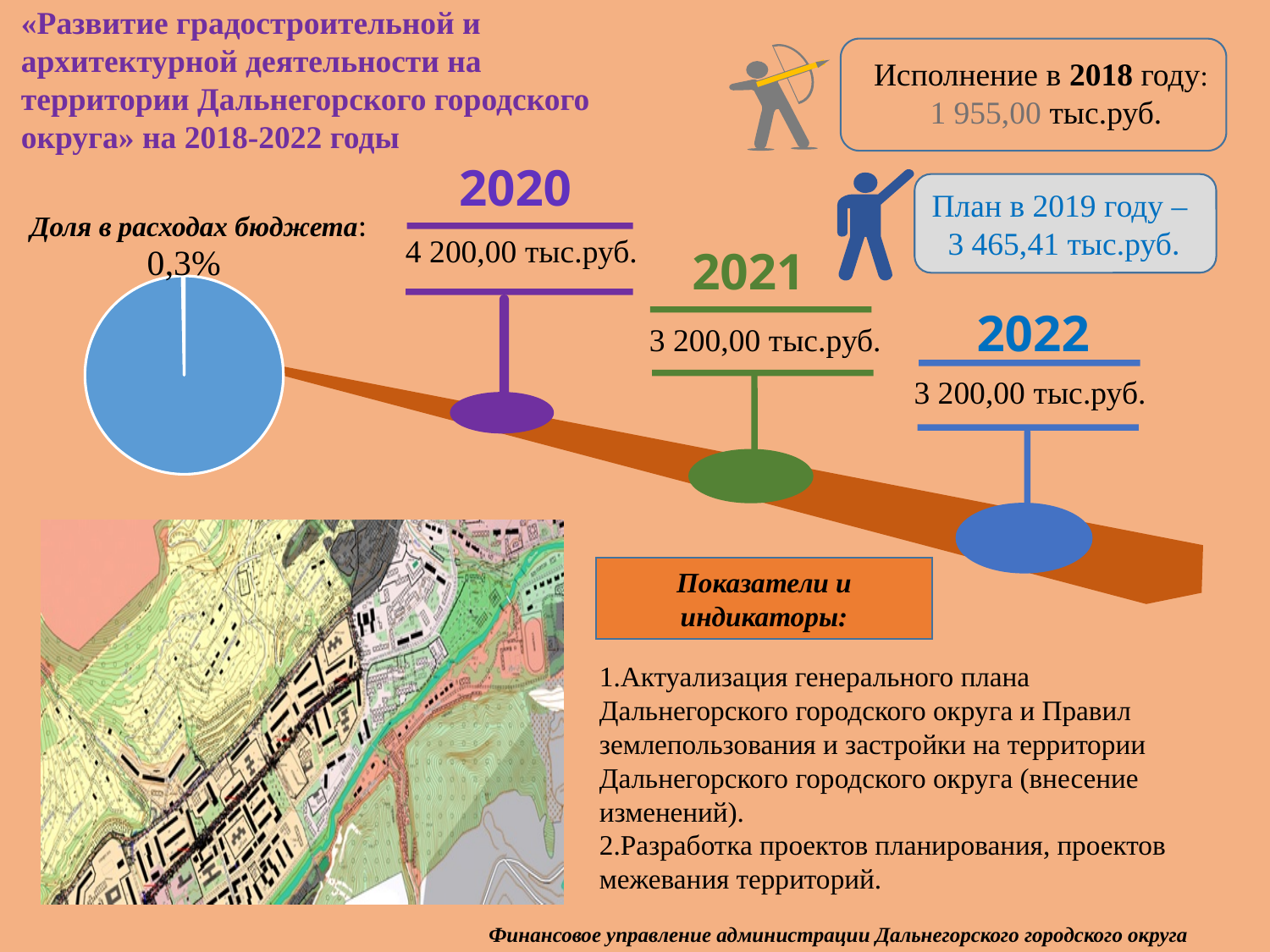
On the pie chart «Доля в расходах бюджета», what share of the budget expenditure does the programme account for? 0,3% On the pie chart «Доля в расходах бюджета», which is larger: the slice labelled 0,3% or the remaining part of the pie? the remaining part of the pie What is the title written above the pie chart on the left of the slide? Доля в расходах бюджета What kind of chart is shown under the heading «Доля в расходах бюджета»? pie chart What colour is the large slice of the pie chart «Доля в расходах бюджета»? blue What value is printed as the data label on the pie chart «Доля в расходах бюджета»? 0,3%